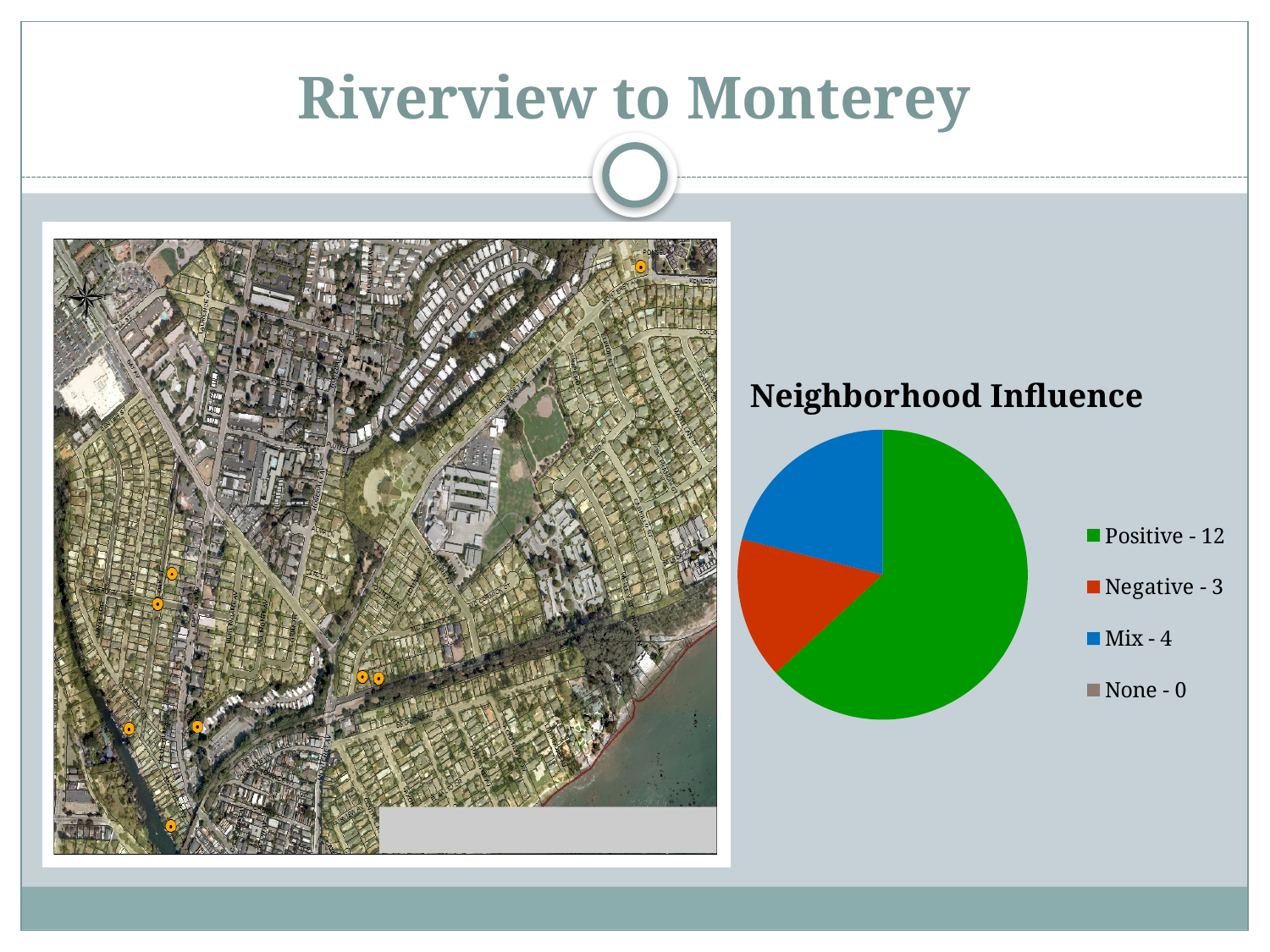
What colour represents Positive in the Neighborhood Influence chart? green What type of chart is shown under the title "Neighborhood Influence"? pie chart How many entries does the legend of the Neighborhood Influence chart list? 4 In the Neighborhood Influence chart, what is the difference between the Positive and Negative values? 9 What is the value for Negative in the Neighborhood Influence chart? 3 What is the value for Positive in the Neighborhood Influence chart? 12 What is the title of the chart on the slide? Neighborhood Influence In the Neighborhood Influence chart, which is larger, Mix or Negative? Mix Which category has the largest value in the Neighborhood Influence chart? Positive What is the value for Mix in the Neighborhood Influence chart? 4 What is the value for None in the Neighborhood Influence chart? 0 Which category has the smallest value in the Neighborhood Influence chart? None